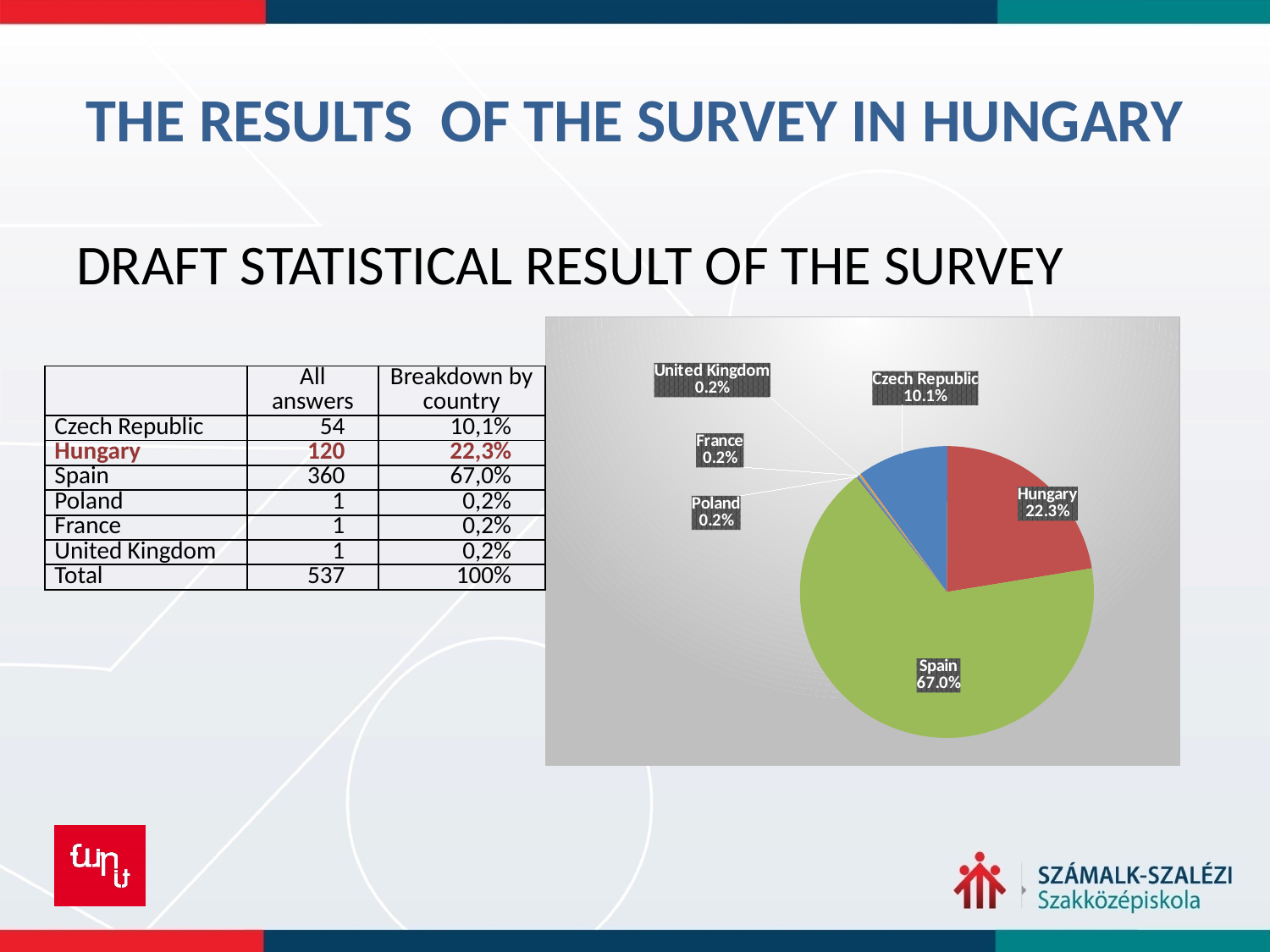
What is the difference between Hungary's share and the Czech Republic's share in the pie chart? 12.2% What share of the pie does Spain have? 67.0% Which country has the largest slice of the pie? Spain What share of the pie does the Czech Republic have? 10.1% What share of the pie does Poland have? 0.2% What is the difference between Spain's share and Hungary's share in the pie chart? 44.7% What colour is the Spain slice in the pie chart? Green What kind of chart is shown on the slide? Pie chart How many slices does the pie chart have? 6 Which is larger in the pie chart, Hungary or the Czech Republic? Hungary What share of the pie does Hungary have? 22.3% What colour is the Hungary slice in the pie chart? Red